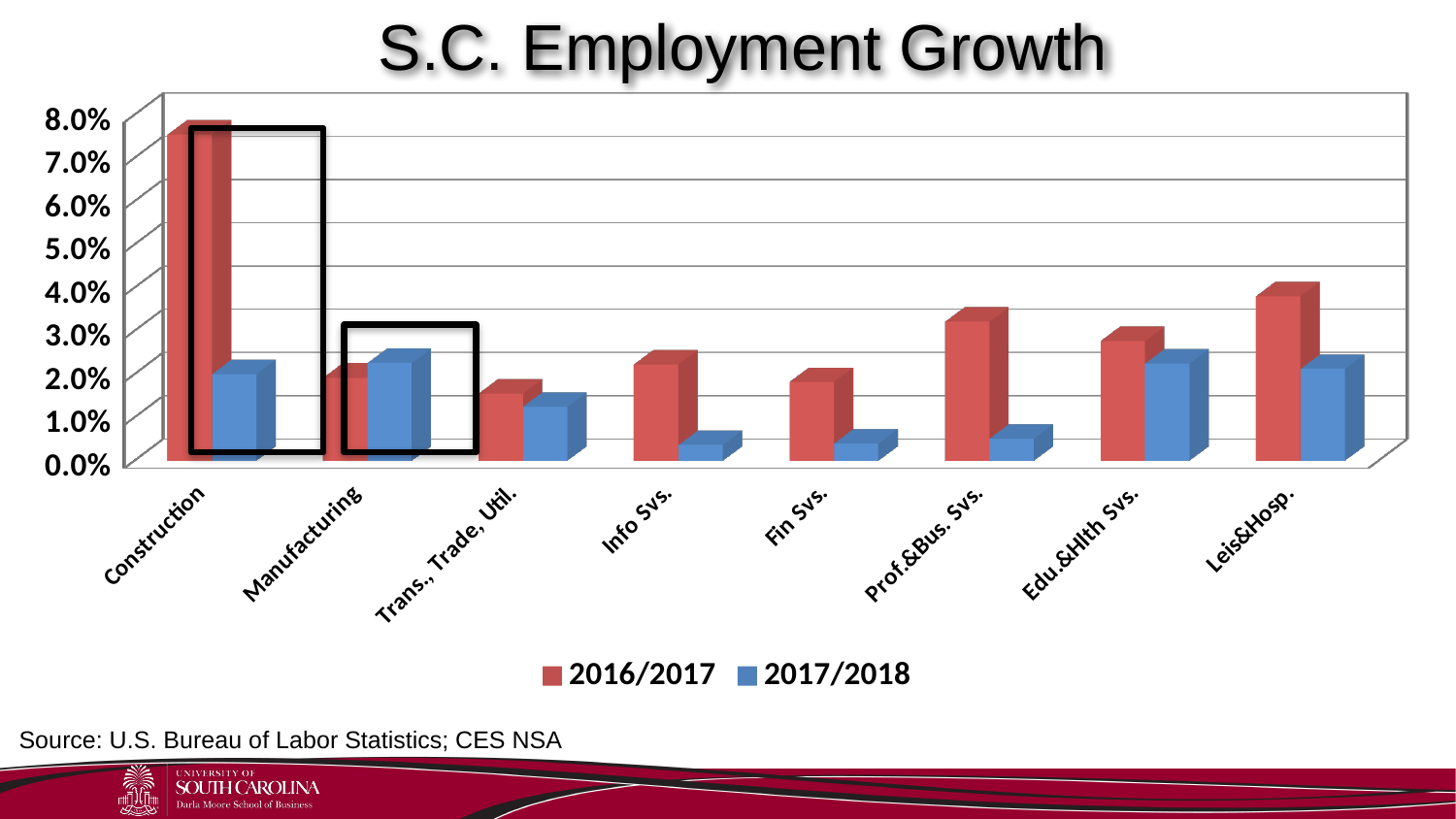
Which category has the highest 2016/2017 value? Construction For Prof.&Bus. Svs., which series has the larger value, 2016/2017 or 2017/2018? 2016/2017 What is the title of the chart? S.C. Employment Growth How many series does the legend list? 2 Is the 2017/2018 value for Edu.&Hlth Svs. greater or less than 1.0%? greater Is the 2017/2018 value for Info Svs. greater or less than 1.0%? less For Construction, which series has the larger value, 2016/2017 or 2017/2018? 2016/2017 Is the 2016/2017 value for Construction greater or less than 6.0%? greater What kind of chart is shown on the slide? bar chart Which category has the lowest 2016/2017 value? Trans., Trade, Util. How many industry categories are shown on the x axis? 8